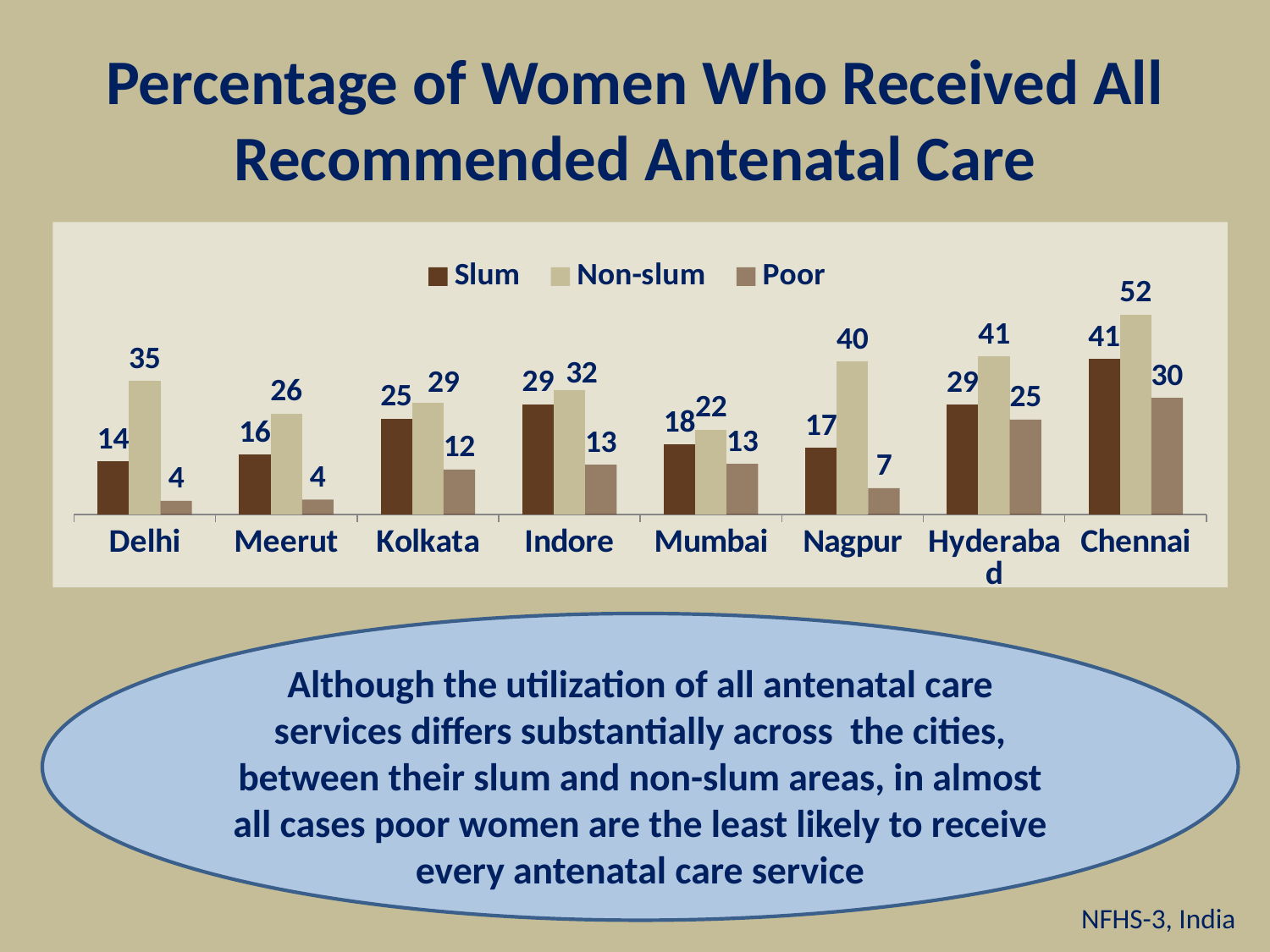
Which city has the highest Non-slum value? Chennai What is the difference between the Non-slum and Slum values for Delhi? 21 What kind of chart is shown on the slide? Bar chart Which is larger for Hyderabad, the Slum value or the Poor value? Slum What is the Poor value for Nagpur? 7 How many series does the legend list? 3 What is the difference between the Non-slum and Poor values for Nagpur? 33 Which city has the lowest Slum value? Delhi Which series is shown in the darkest brown colour? Slum What is the Slum value for Indore? 29 How many cities are shown on the x axis? 8 What is the Non-slum value for Chennai? 52